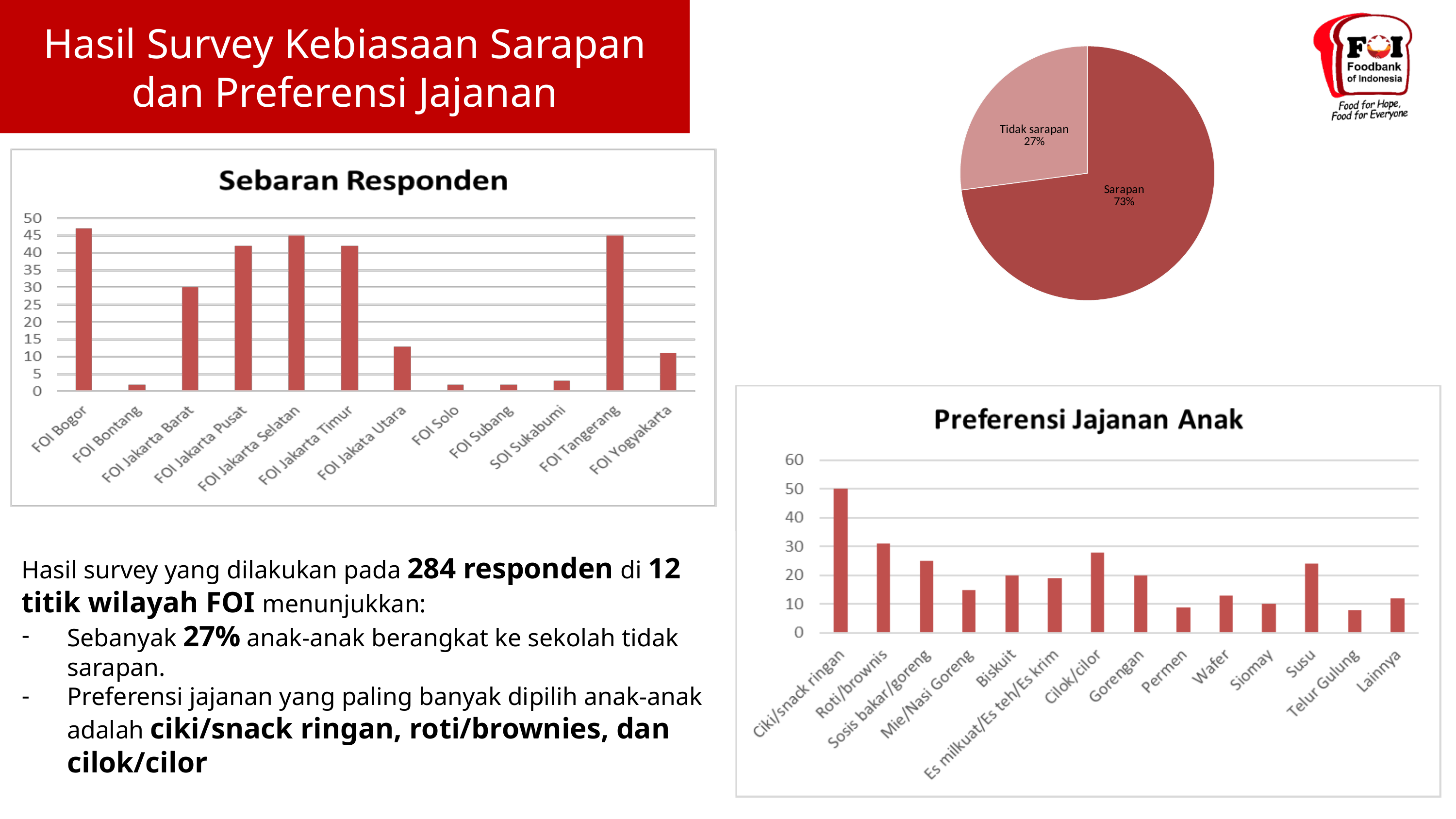
What kind of chart is "Preferensi Jajanan Anak"? bar chart In the pie chart, what is the difference in percentage points between the Sarapan and Tidak sarapan slices? 46 In the "Sebaran Responden" chart, how many categories are shown on the x axis? 12 In the pie chart, what percentage of respondents are labelled "Sarapan"? 73% In the "Preferensi Jajanan Anak" chart, how many categories are shown on the x axis? 14 In the "Preferensi Jajanan Anak" chart, is the value for Roti/brownis greater or less than 20? greater In the "Preferensi Jajanan Anak" chart, which category has the highest value? Ciki/snack ringan In the "Sebaran Responden" chart, is the value for FOI Jakarta Utara greater or less than 20? less In the pie chart, which slice is larger, Sarapan or Tidak sarapan? Sarapan In the "Sebaran Responden" chart, which category has the highest value? FOI Bogor In the pie chart, what share is labelled "Tidak sarapan"? 27% In the "Sebaran Responden" chart, which is larger, FOI Jakarta Barat or FOI Yogyakarta? FOI Jakarta Barat